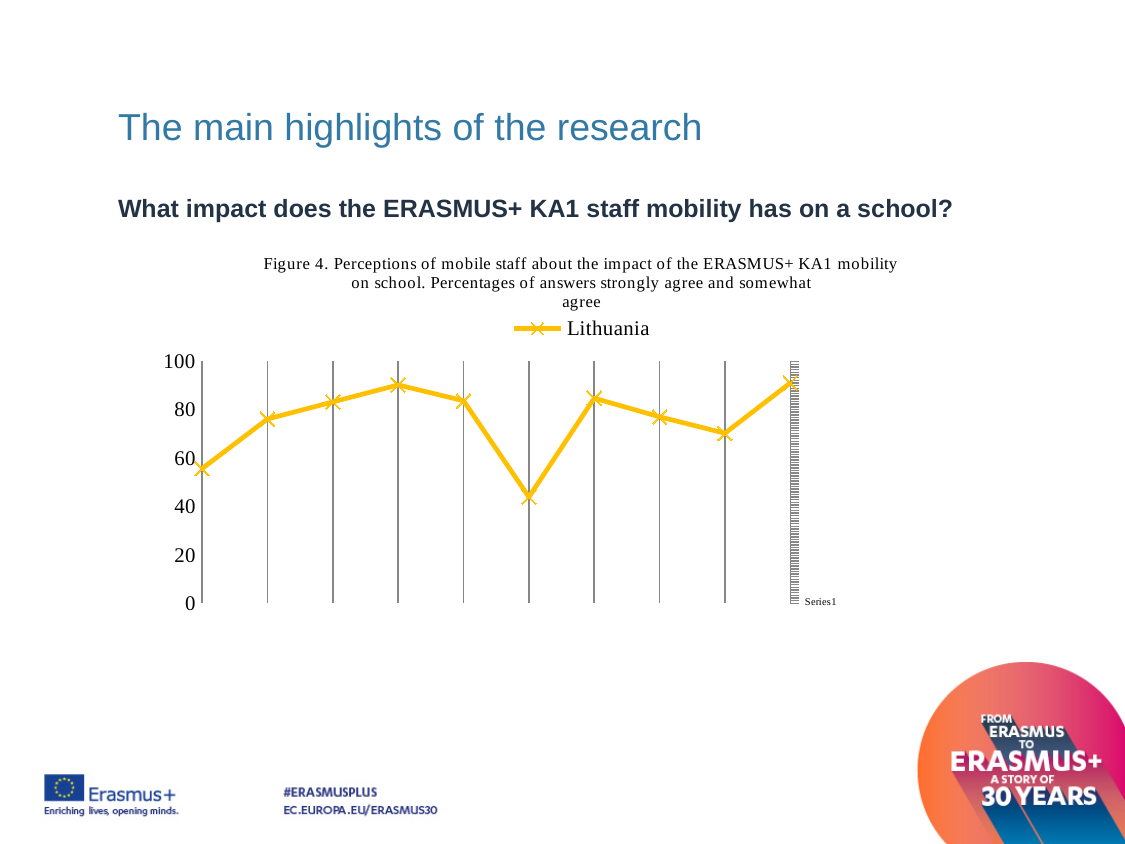
What kind of chart is shown on the slide? line chart Is the value of the ninth point on the Lithuania line greater or less than 60? greater What is the figure number given in the chart title? Figure 4 Do the values on the Lithuania line rise or fall from the first point to the fourth point? rise Is the value of the sixth point on the Lithuania line greater or less than 60? less Is the value of the fourth point on the Lithuania line greater or less than 80? greater Which data point on the Lithuania line is the lowest? the sixth point What series name appears in the chart legend? Lithuania How many data points are plotted on the Lithuania line? 10 How many series does the chart legend list? 1 Which is larger on the Lithuania line, the second point or the sixth point? the second point